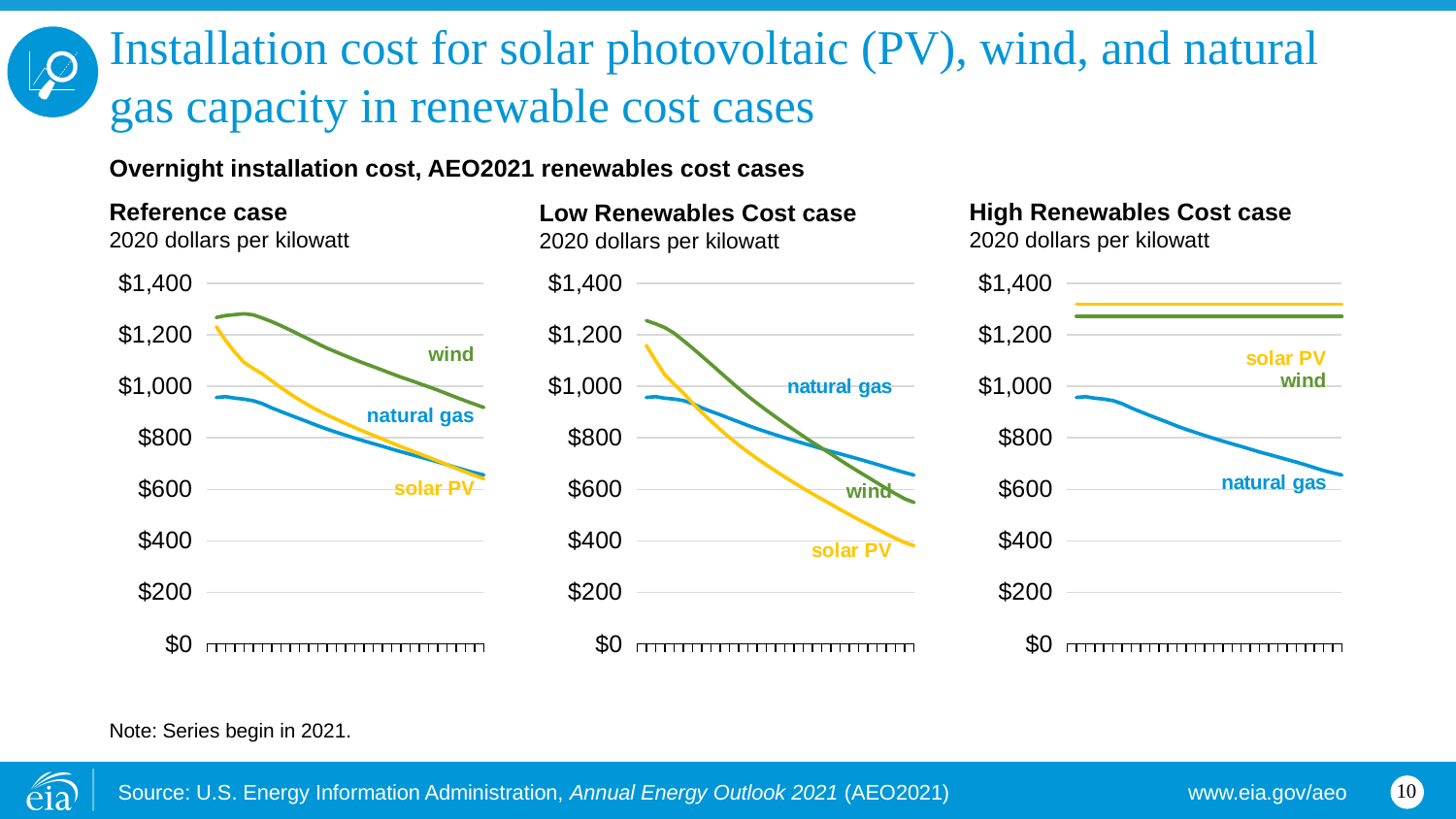
In the Low Renewables Cost case chart, is the final value of solar PV greater or less than $600? less In the Reference case chart, is the starting value of wind greater or less than $1,200? greater In the High Renewables Cost case chart, which series is higher, solar PV or wind? solar PV How many series are plotted in the Reference case chart? 3 What unit is shown under the Low Renewables Cost case chart title? 2020 dollars per kilowatt In the High Renewables Cost case chart, does the solar PV series rise, fall, or stay flat along the x axis? flat How many charts are shown on the slide? 3 In the Reference case chart, does the solar PV series rise or fall along the x axis? fall What type of chart is the Reference case chart? line chart In the High Renewables Cost case chart, is the solar PV value greater or less than $1,200? greater In the Reference case chart, which series has the highest value at the end of the x axis? wind What is the overall heading above the three charts? Overnight installation cost, AEO2021 renewables cost cases